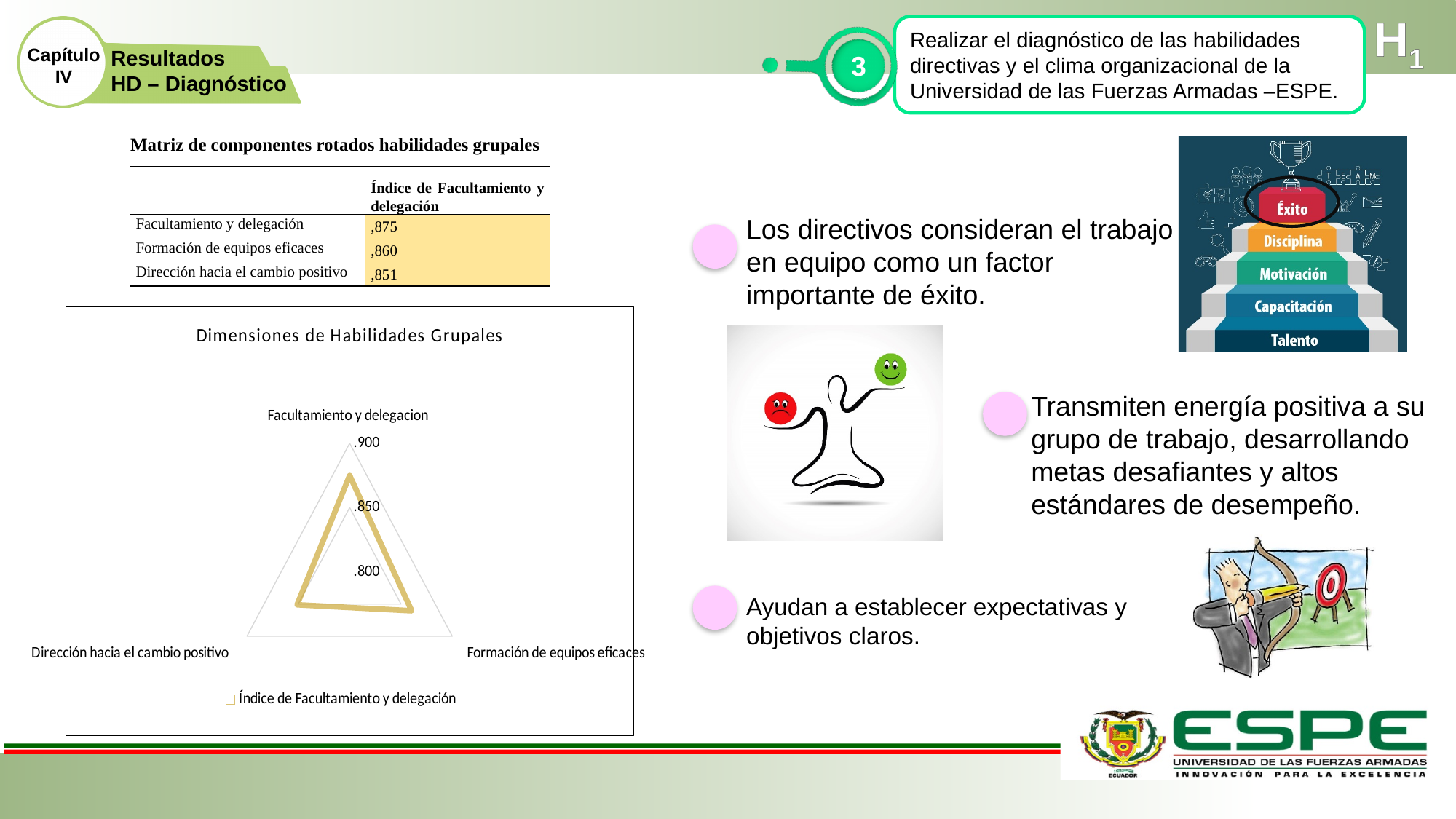
What is the title of the radar chart on the slide? Dimensiones de Habilidades Grupales In the "Dimensiones de Habilidades Grupales" chart, is the value for Formación de equipos eficaces greater or less than .800? greater How many categories are plotted on the "Dimensiones de Habilidades Grupales" chart? 3 In the "Dimensiones de Habilidades Grupales" chart, is the value for Facultamiento y delegacion greater or less than .850? greater How many series does the legend of the "Dimensiones de Habilidades Grupales" chart list? 1 What kind of chart is "Dimensiones de Habilidades Grupales"? Radar chart In the "Dimensiones de Habilidades Grupales" chart, is the value for Facultamiento y delegacion greater or less than .900? less What series name appears in the legend of the "Dimensiones de Habilidades Grupales" chart? Índice de Facultamiento y delegación